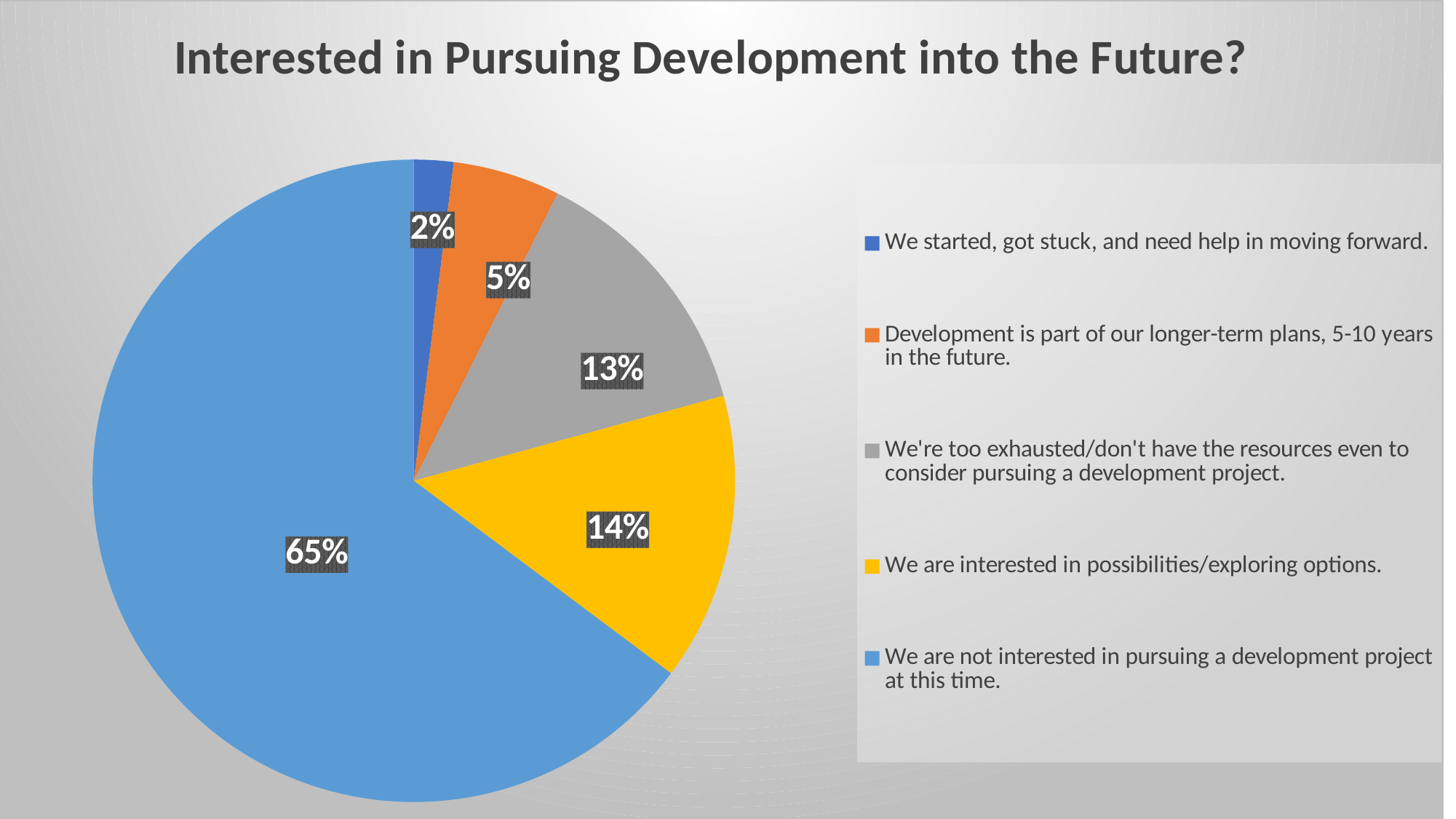
What is the title of the chart? Interested in Pursuing Development into the Future? What percentage is shown for "We are interested in possibilities/exploring options."? 14% Which category has the largest slice of the pie? We are not interested in pursuing a development project at this time. What type of chart is shown on the slide? Pie chart What percentage is shown for "We started, got stuck, and need help in moving forward."? 2% What share of the pie is labelled for "We are not interested in pursuing a development project at this time."? 65% What percentage is shown for "We're too exhausted/don't have the resources even to consider pursuing a development project."? 13% How many categories does the pie chart show? 5 What is the difference in percentage points between the "not interested" slice and the "interested in possibilities/exploring options" slice? 51 What percentage is shown for "Development is part of our longer-term plans, 5-10 years in the future."? 5% Which category has the smallest slice of the pie? We started, got stuck, and need help in moving forward. Which is larger: the slice for "Development is part of our longer-term plans, 5-10 years in the future." or the slice for "We started, got stuck, and need help in moving forward."? Development is part of our longer-term plans, 5-10 years in the future.